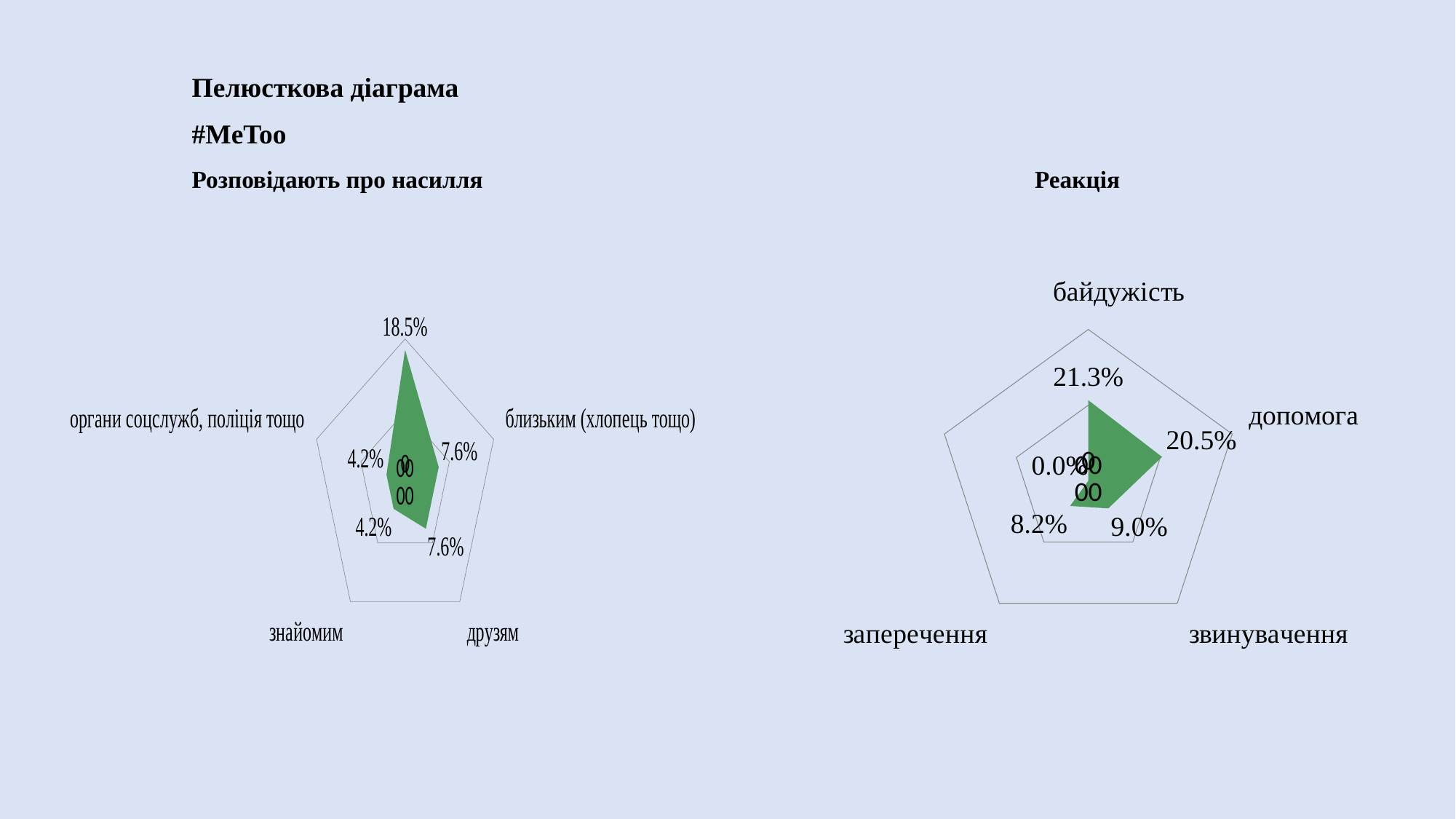
In the 'Реакція' chart, what is the value for допомога? 20.5% In the 'Реакція' chart, what is the value for заперечення? 8.2% In the 'Розповідають про насилля' chart, what is the value for знайомим? 4.2% In the 'Розповідають про насилля' chart, what is the value for органи соцслужб, поліція тощо? 4.2% In the 'Реакція' chart, which is larger, the value for звинувачення or the value for заперечення? звинувачення In the 'Реакція' chart, what is the difference between the values for допомога and звинувачення? 11.5% What kind of chart is the 'Реакція' chart? radar chart How many axes (categories) does the 'Розповідають про насилля' radar chart have? 5 In the 'Реакція' chart, what is the value for звинувачення? 9.0% In the 'Розповідають про насилля' chart, what is the value for близьким (хлопець тощо)? 7.6% In the 'Реакція' chart, what is the value for байдужість? 21.3% In the 'Розповідають про насилля' chart, what is the largest value shown? 18.5%